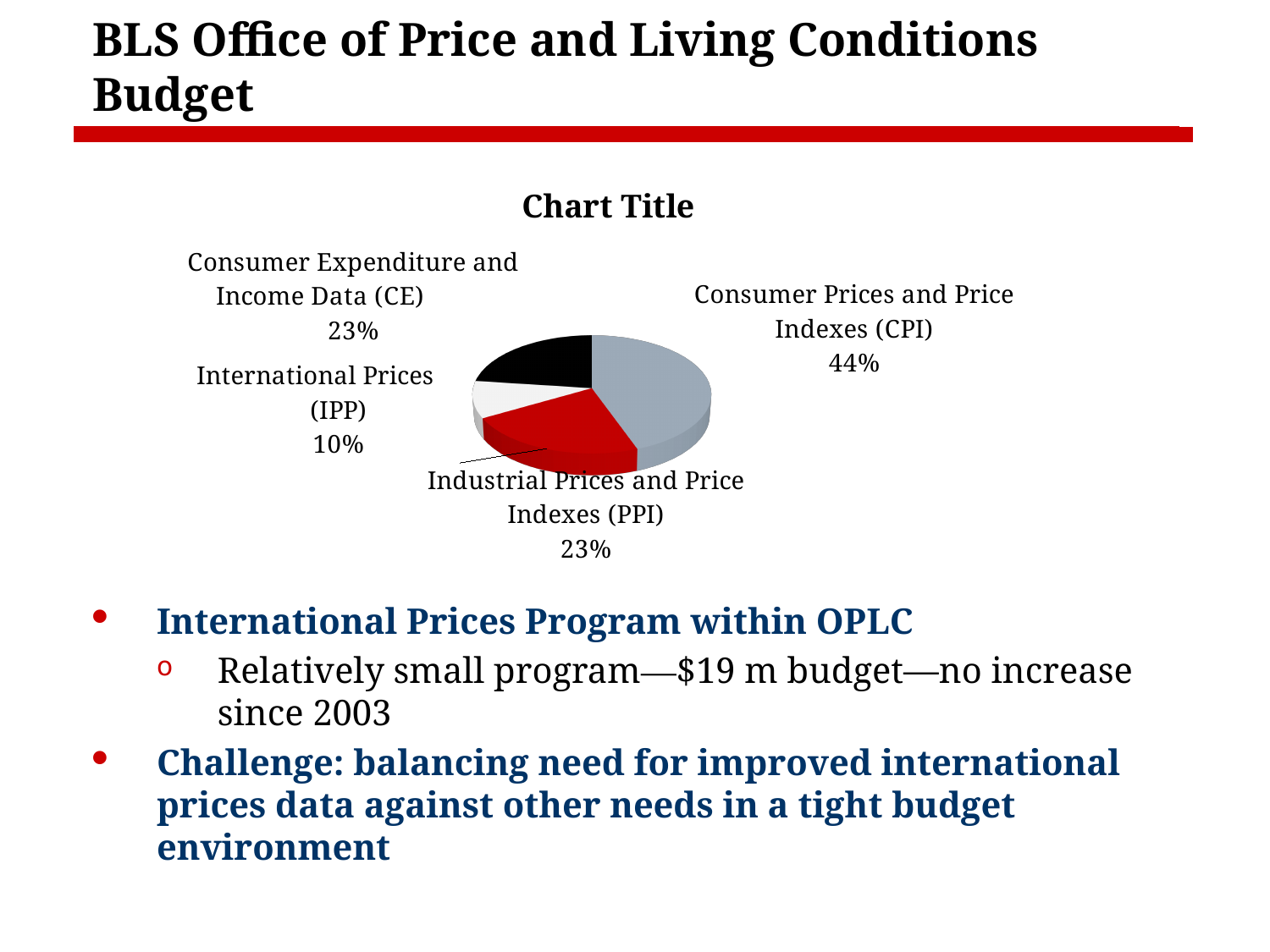
What is the value shown for Industrial Prices and Price Indexes (PPI)? 23% How many slices does the pie chart have? 4 What is the difference between the CPI share and the IPP share? 34% What kind of chart is shown on the slide? Pie chart What is the value shown for Consumer Expenditure and Income Data (CE)? 23% Which category has the largest slice of the pie? Consumer Prices and Price Indexes (CPI) What is the difference between the CPI share and the PPI share? 21% Which is larger, the share for CPI or the share for CE? CPI What is the title printed above the pie chart? Chart Title What share of the pie does Consumer Prices and Price Indexes (CPI) have? 44% What share of the pie does International Prices (IPP) have? 10% Which category has the smallest slice of the pie? International Prices (IPP)